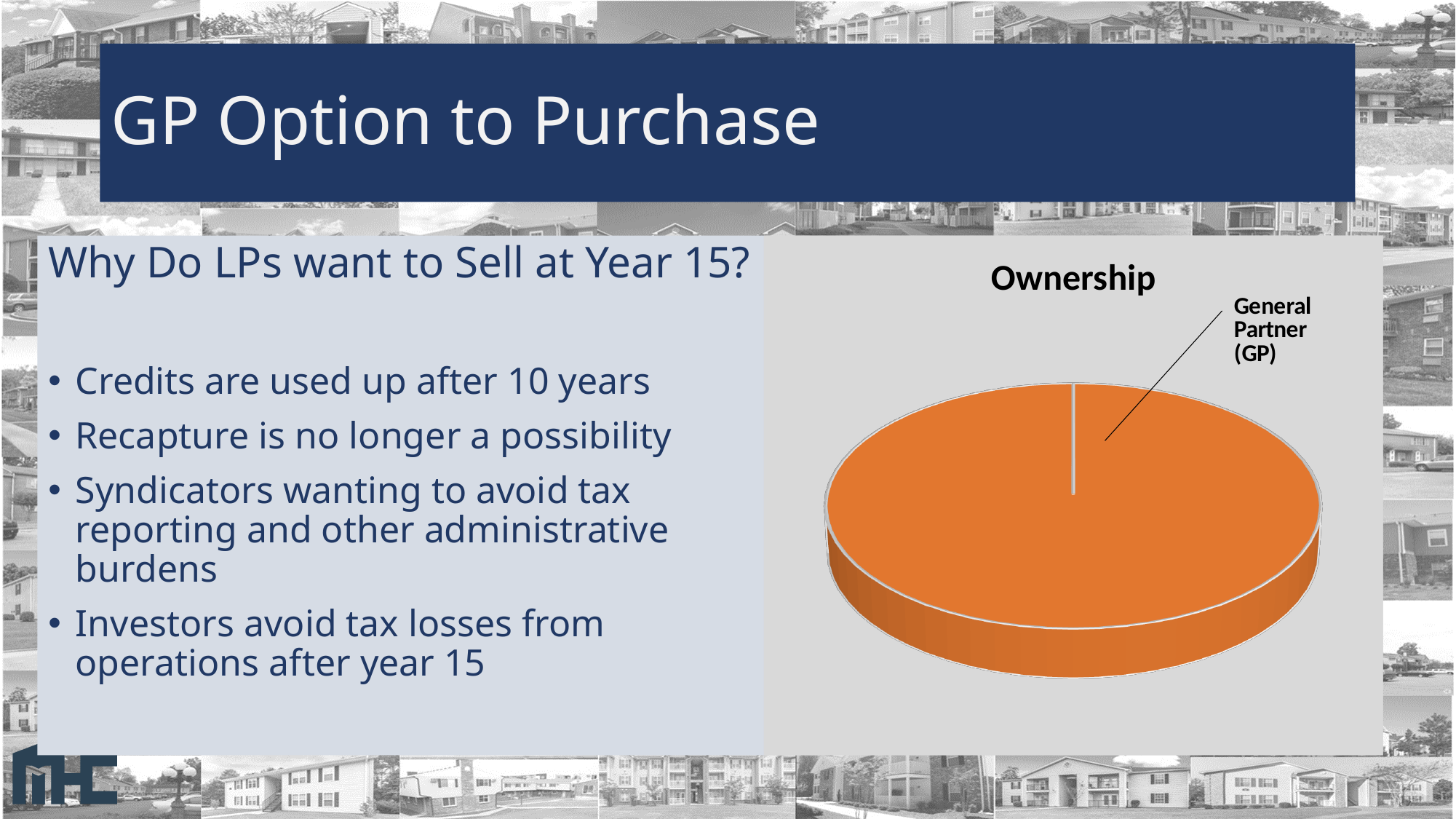
What kind of chart is shown on the slide? pie chart What is the title of the chart on the slide? Ownership In the Ownership pie chart, is the General Partner (GP) slice more or less than half of the pie? more Which slice of the Ownership pie chart is labeled on the slide? General Partner (GP)